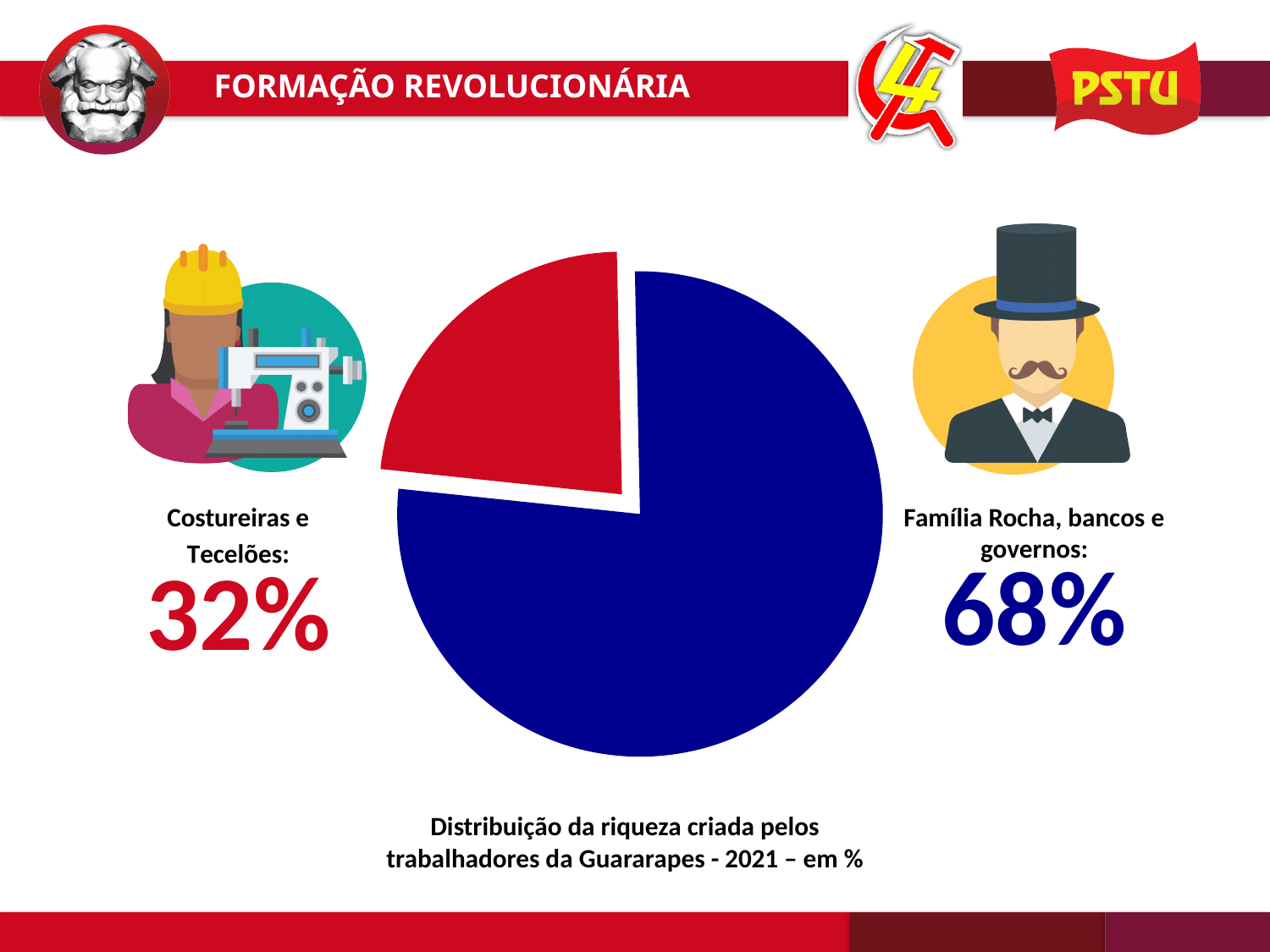
What is the difference in percentage points between the share for Família Rocha, bancos e governos and the share for Costureiras e Tecelões? 36 What colour is the slice for Costureiras e Tecelões? red Which slice of the pie is the smallest? Costureiras e Tecelões What year does the chart caption refer to? 2021 What kind of chart is shown on the slide? pie chart What is the total of the two slices shown? 100% Which is larger: the share for Costureiras e Tecelões or the share for Família Rocha, bancos e governos? Família Rocha, bancos e governos What share of the wealth goes to Costureiras e Tecelões? 32% How many slices does the pie chart have? 2 Which slice of the pie is the largest? Família Rocha, bancos e governos What share of the wealth goes to Família Rocha, bancos e governos? 68%